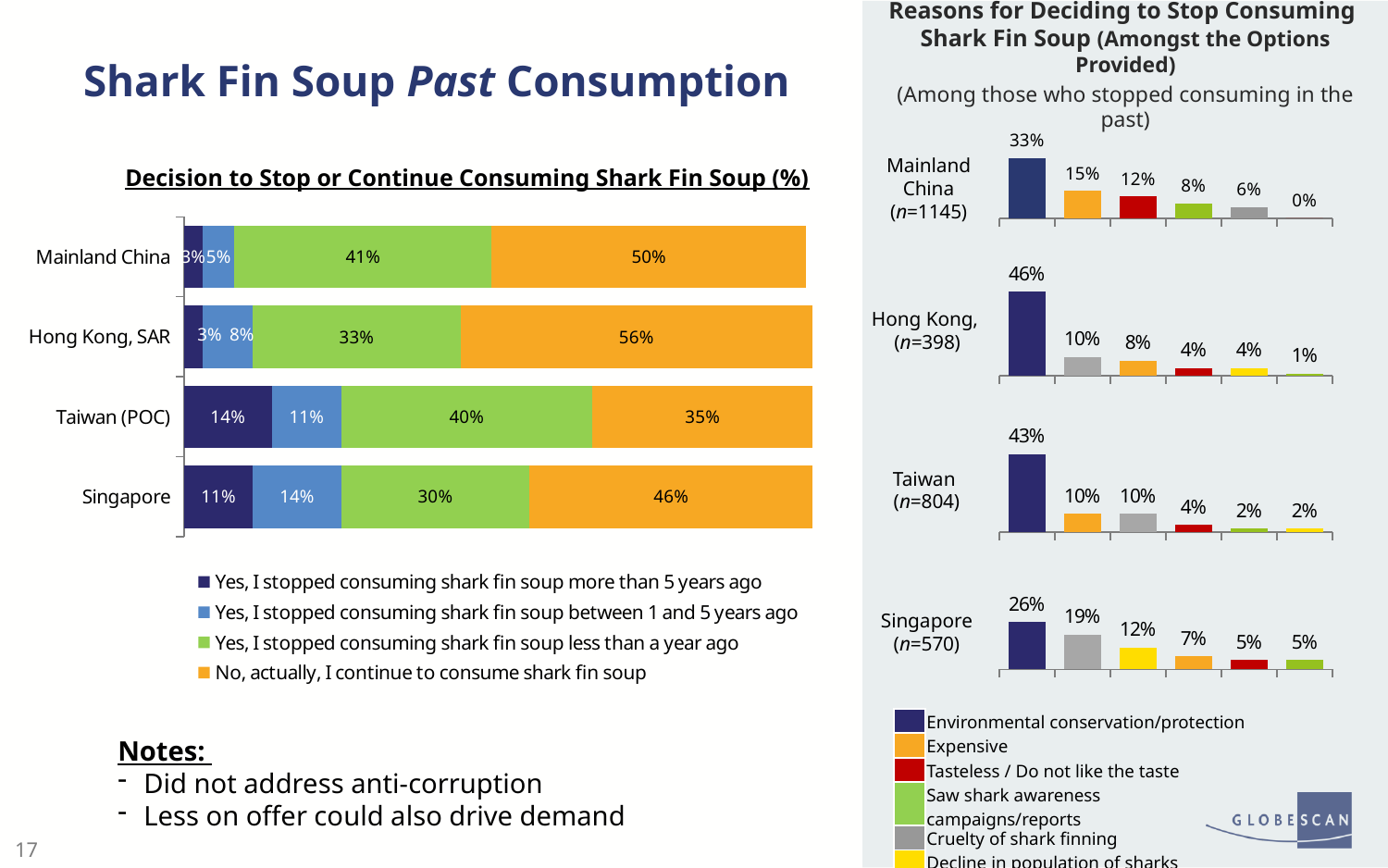
In the 'Decision to Stop or Continue Consuming Shark Fin Soup (%)' chart, which is larger: the share of Taiwan (POC) respondents who stopped less than a year ago or the share of Singapore respondents who stopped less than a year ago? Taiwan (POC) In the 'Reasons for Deciding to Stop Consuming Shark Fin Soup' charts, what percentage of Hong Kong respondents cited environmental conservation/protection? 46% In the 'Reasons for Deciding to Stop Consuming Shark Fin Soup' charts, what is the highest value shown for Singapore? 26% How many series does the legend of the 'Decision to Stop or Continue Consuming Shark Fin Soup (%)' chart list? 4 What type of chart is the 'Decision to Stop or Continue Consuming Shark Fin Soup (%)' chart? Stacked bar chart In the 'Decision to Stop or Continue Consuming Shark Fin Soup (%)' chart, what percentage of Taiwan (POC) respondents stopped consuming shark fin soup more than 5 years ago? 14% In the 'Decision to Stop or Continue Consuming Shark Fin Soup (%)' chart, what percentage of Hong Kong, SAR respondents said they continue to consume shark fin soup? 56% In the 'Decision to Stop or Continue Consuming Shark Fin Soup (%)' chart, what percentage of Singapore respondents stopped consuming shark fin soup less than a year ago? 30% In the 'Decision to Stop or Continue Consuming Shark Fin Soup (%)' chart, which market has the highest share of respondents who continue to consume shark fin soup? Hong Kong, SAR How many markets are shown in the 'Decision to Stop or Continue Consuming Shark Fin Soup (%)' chart? 4 In the 'Decision to Stop or Continue Consuming Shark Fin Soup (%)' chart, which market has the lowest share of respondents who continue to consume shark fin soup? Taiwan (POC) In the 'Decision to Stop or Continue Consuming Shark Fin Soup (%)' chart, what is the difference between Mainland China and Singapore in the share who continue to consume shark fin soup? 4%